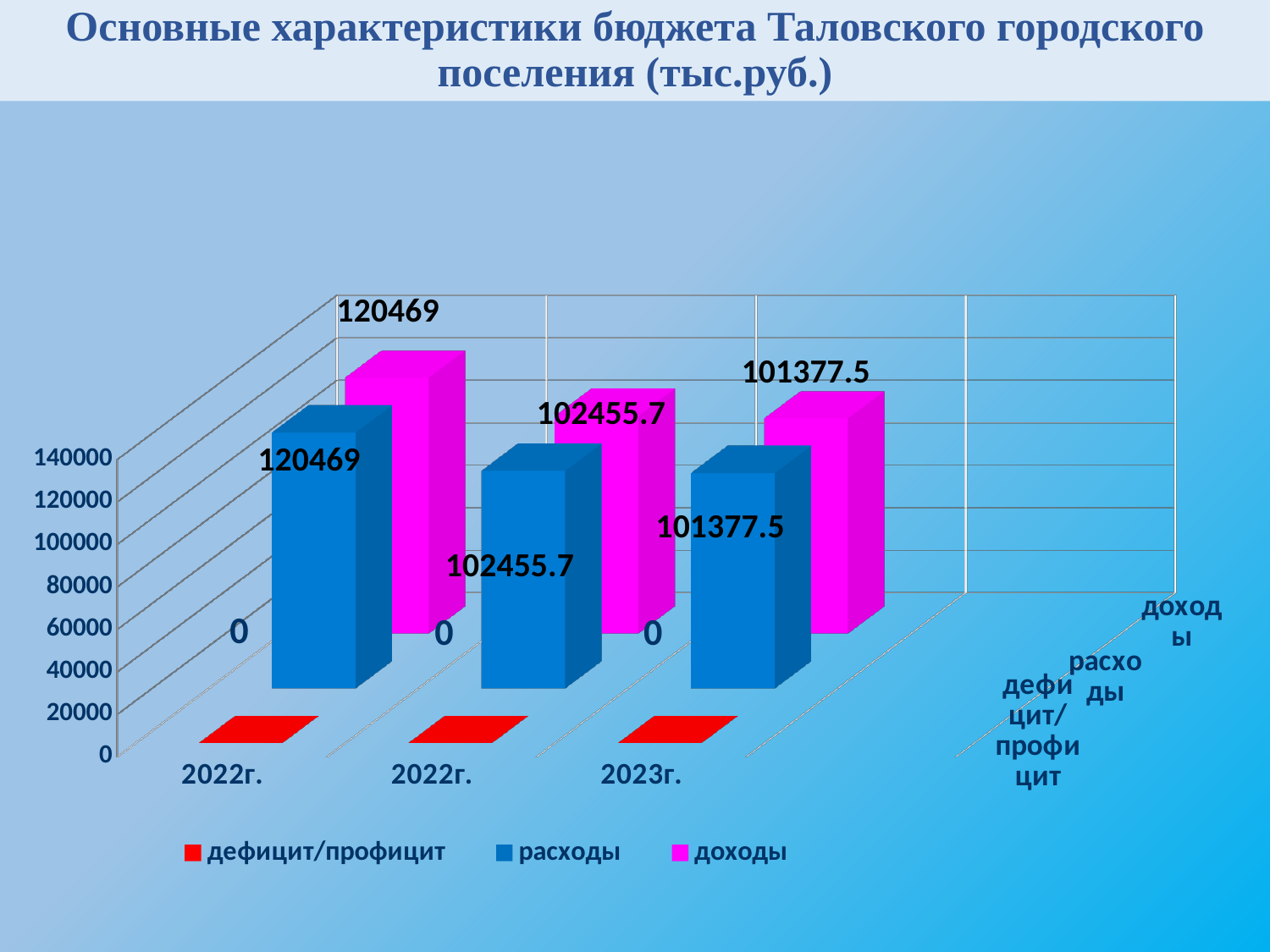
Which category has the highest value of доходы? the leftmost category (2022г.) What is the value of дефицит/профицит for 2023г.? 0 What is the value of расходы for the middle category on the x axis? 102455.7 What is the value of расходы for 2023г.? 101377.5 Is the value of расходы for 2023г. greater or less than 120000? less How many series does the legend list? 3 What is the value of доходы for 2023г.? 101377.5 Do the values of доходы rise or fall from left to right along the x axis? fall What is the difference between доходы in the leftmost category (120469) and доходы in 2023г.? 19091.5 What colour are the bars for the доходы series? magenta What kind of chart is shown on the slide? bar chart How many categories are shown along the x axis? 3